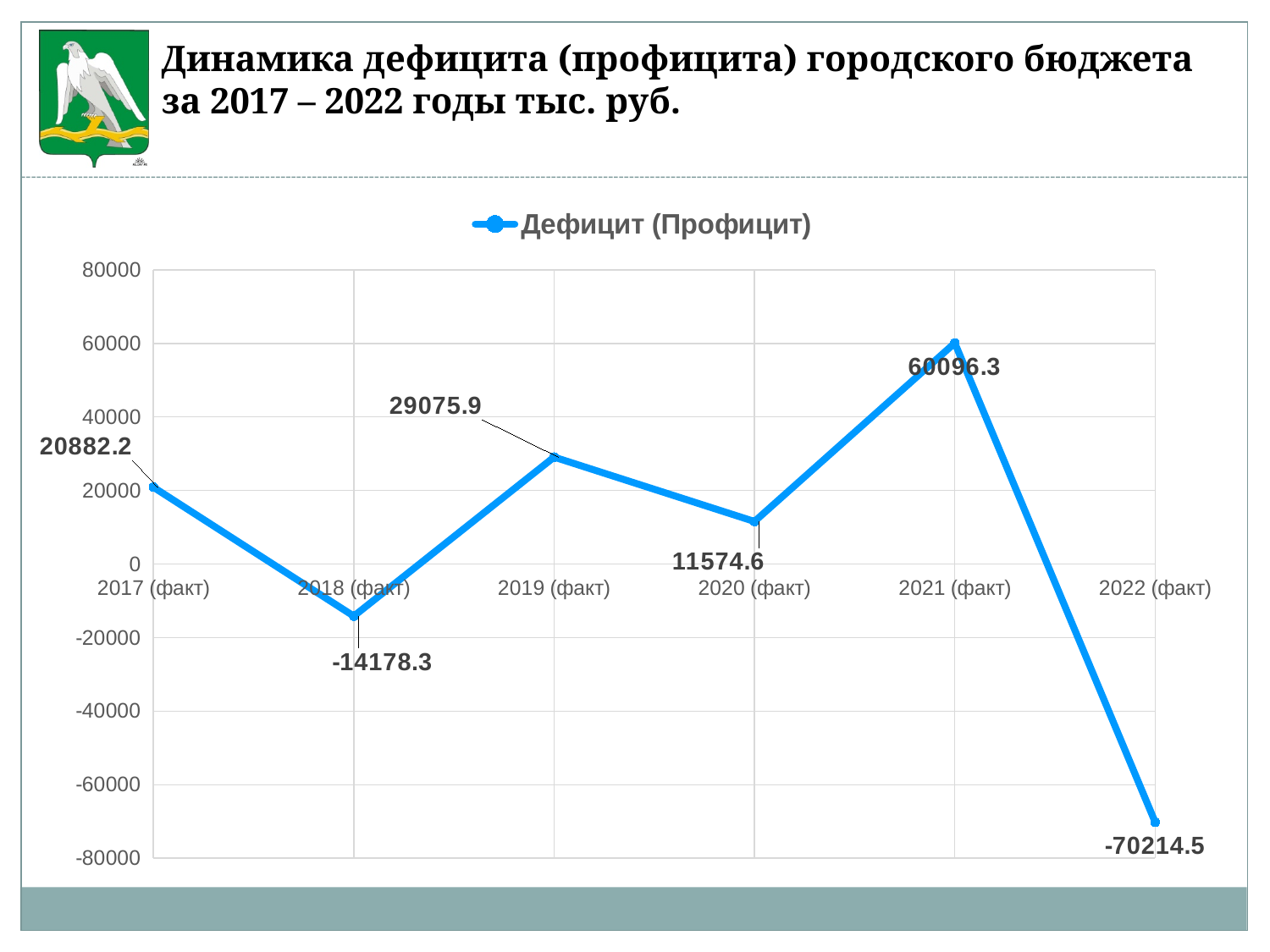
What is the difference between the values for 2019 (факт) and 2020 (факт)? 17501.3 What is the value for 2018 (факт)? -14178.3 What is the value for 2017 (факт)? 20882.2 What series name is shown in the legend? Дефицит (Профицит) Which is larger, the value for 2017 (факт) or the value for 2019 (факт)? 2019 (факт) What kind of chart is shown on the slide? line chart Which year has the highest value? 2021 (факт) Which year has the lowest value? 2022 (факт) What is the value for 2021 (факт)? 60096.3 What is the value for 2022 (факт)? -70214.5 How many data points are plotted on the chart? 6 Is the value for 2021 (факт) greater or less than 40000? greater